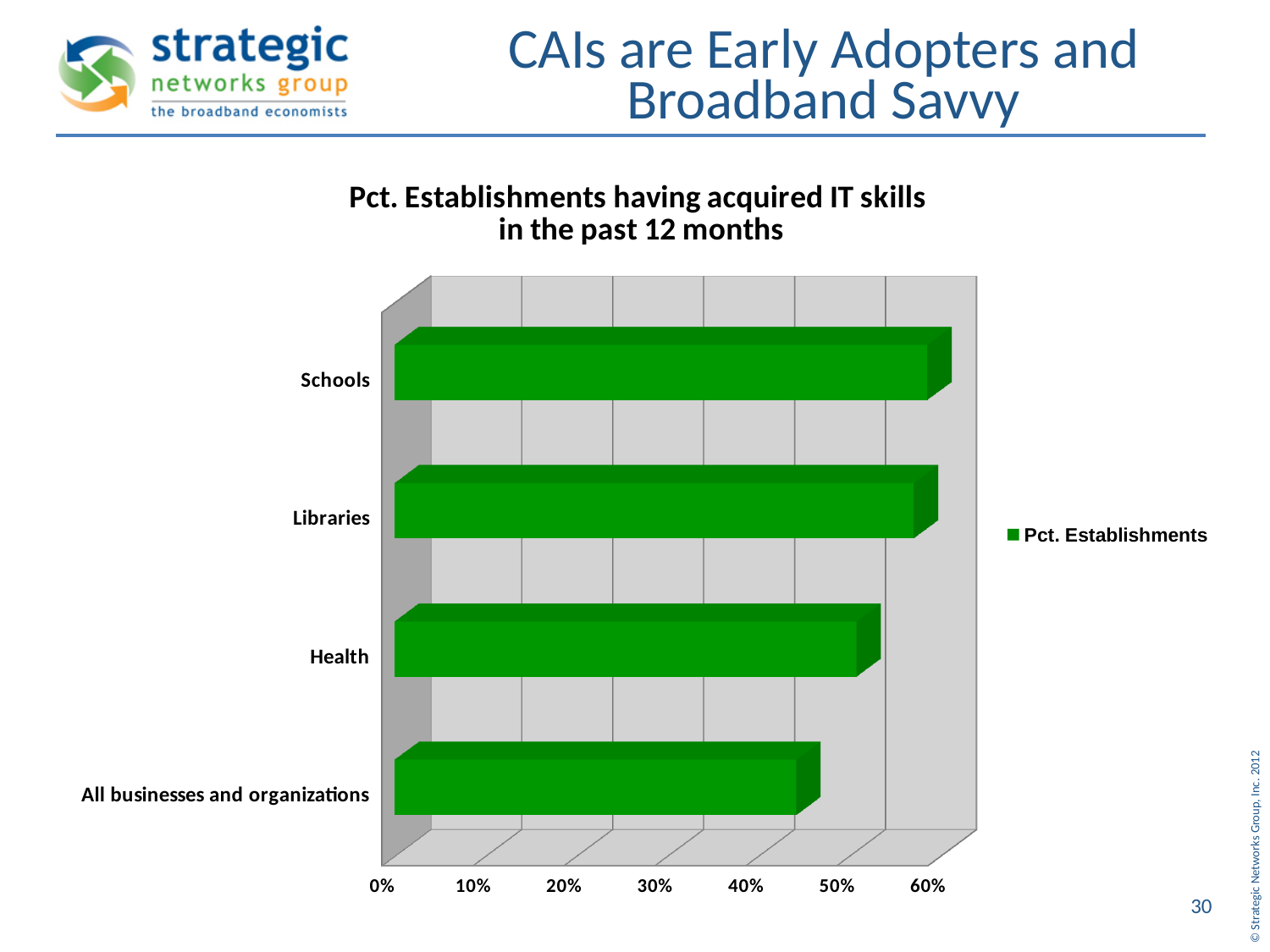
What is the name of the series shown in the legend? Pct. Establishments What is the title of the chart? Pct. Establishments having acquired IT skills in the past 12 months Is the value for Schools greater or less than 50%? greater How many series does the legend list? 1 Which is larger, the value for Libraries or the value for Health? Libraries Which category has the lowest percentage of establishments having acquired IT skills? All businesses and organizations Is the value for Health greater or less than 40%? greater Is the value for All businesses and organizations greater or less than 50%? less How many categories are plotted in the chart? 4 Which is larger, the value for Schools or the value for All businesses and organizations? Schools What kind of chart is shown on the slide? Bar chart